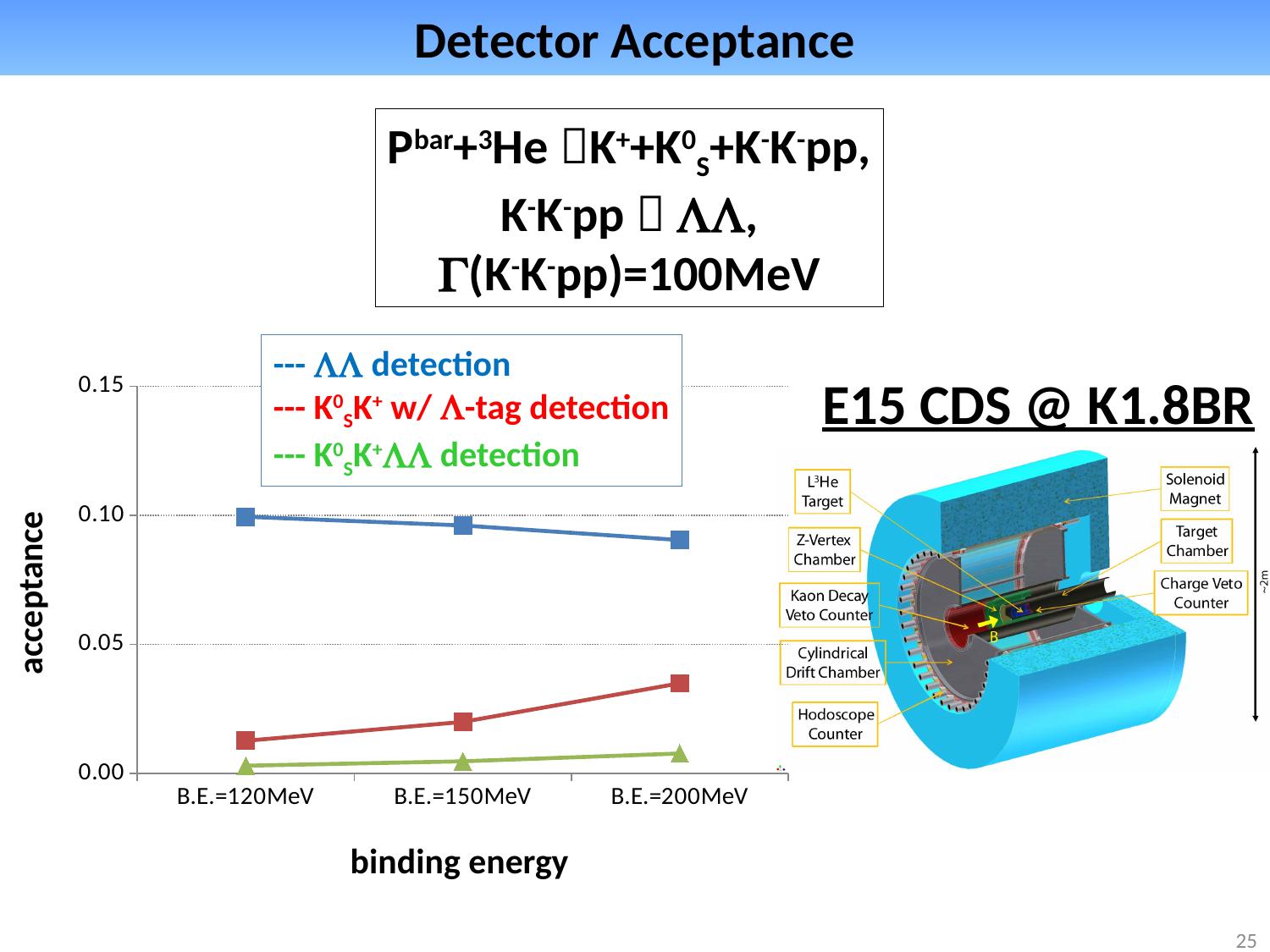
How many binding energy categories are plotted on the x axis? 3 At which binding energy is the acceptance for K0sK+ w/ Λ-tag detection highest? B.E.=200MeV Is the acceptance for ΛΛ detection at B.E.=200MeV greater or less than 0.10? less Does the acceptance for K0sK+ w/ Λ-tag detection rise or fall as binding energy increases from 120MeV to 200MeV? rise Is the acceptance for K0sK+ w/ Λ-tag detection at B.E.=200MeV greater or less than 0.05? less Is the acceptance for ΛΛ detection at B.E.=150MeV greater or less than 0.05? greater How many series does the legend list? 3 What is the label of the y axis of the chart? acceptance What kind of chart is shown on the slide? line chart Does the acceptance for ΛΛ detection rise or fall as binding energy increases from 120MeV to 200MeV? fall At B.E.=120MeV, which series has the higher acceptance: ΛΛ detection or K0sK+ w/ Λ-tag detection? ΛΛ detection At which binding energy is the acceptance for ΛΛ detection lowest? B.E.=200MeV